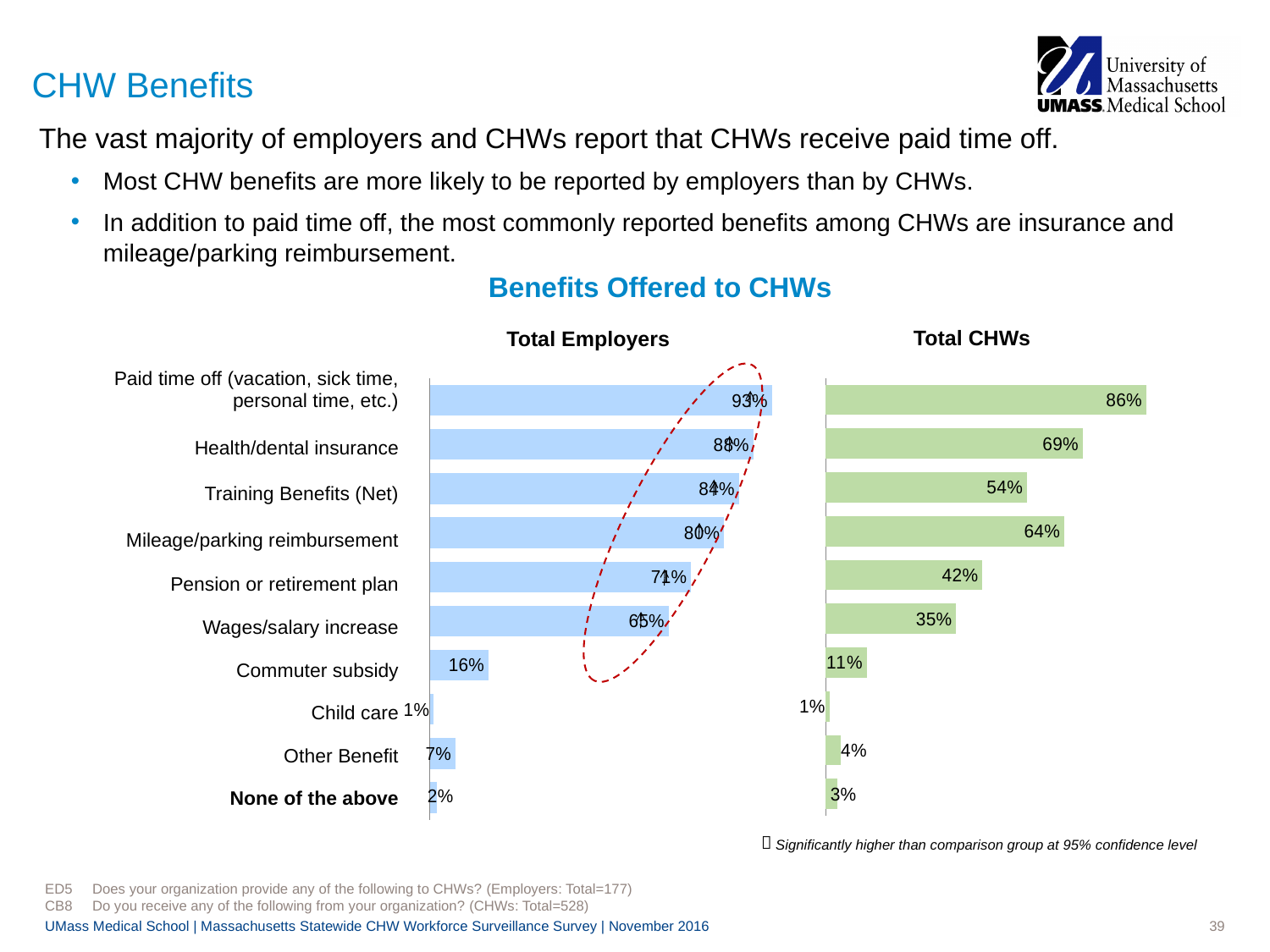
What is the difference between the Total Employers and Total CHWs values for Health/dental insurance? 19 percentage points In the Total Employers chart, what percentage of employers report offering a commuter subsidy? 16% In the Total CHWs chart, which category has the lowest value? Child care In the Total CHWs chart, what percentage of CHWs report receiving paid time off? 86% What type of chart is used for the Total CHWs data? Bar chart How many benefit categories are listed in the Total Employers chart? 10 In the Total Employers chart, what is the value for Other Benefit? 7% In the Total CHWs chart, what is the difference between Pension or retirement plan and Wages/salary increase? 7 percentage points In the Total CHWs chart, which benefit has the highest value? Paid time off (vacation, sick time, personal time, etc.) What is the title shown above the two charts? Benefits Offered to CHWs In the Total CHWs chart, which is larger: Training Benefits (Net) or Mileage/parking reimbursement? Mileage/parking reimbursement In the Total CHWs chart, what is the value for Mileage/parking reimbursement? 64%